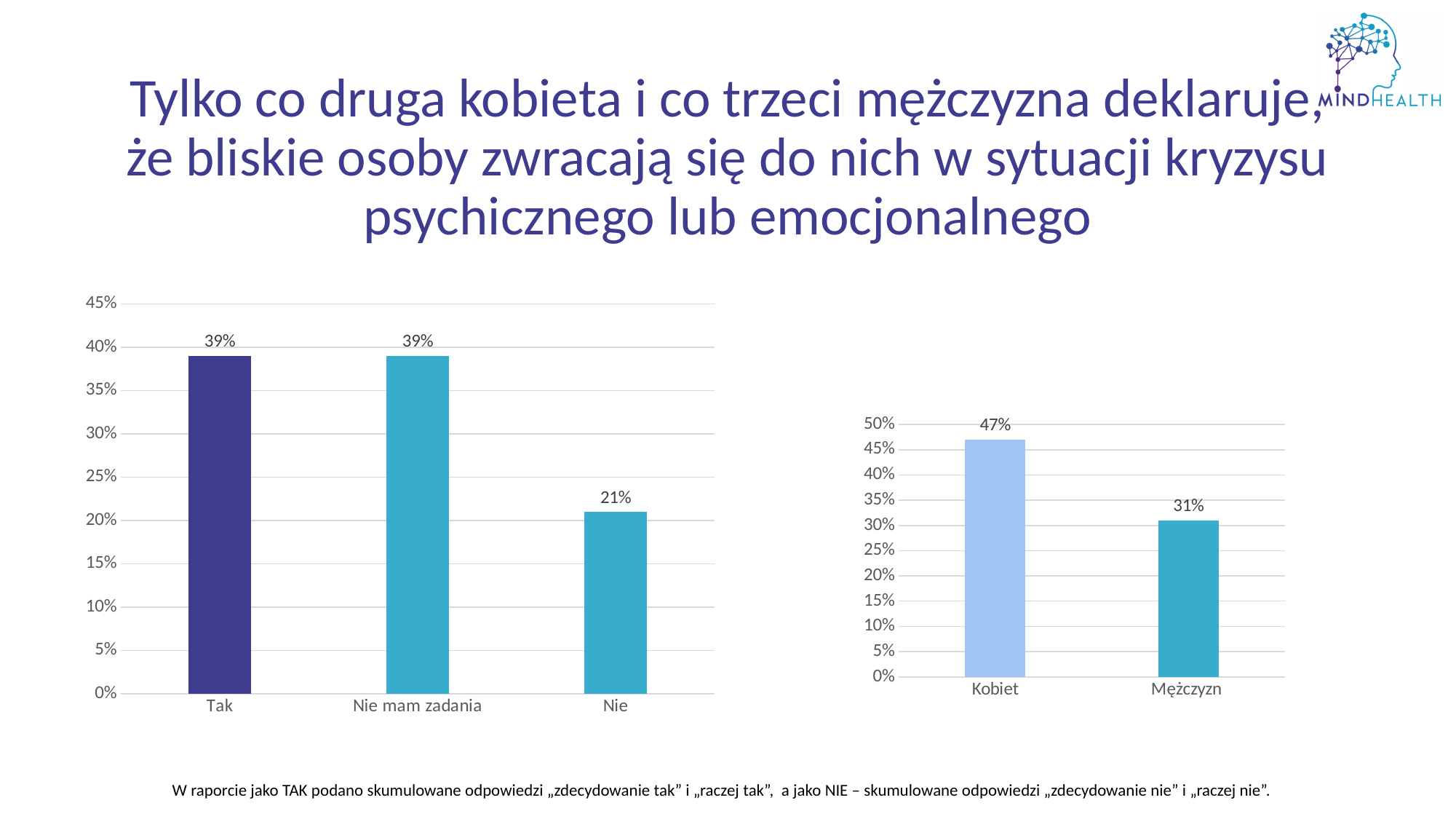
In the left chart, what is the value for "Tak"? 39% In the left chart, what is the value for "Nie"? 21% What kind of chart is the right chart? Bar chart In the right chart, is the value for "Mężczyzn" greater or less than 35%? less In the left chart, how many categories are shown? 3 In the left chart, what is the value for "Nie mam zdania"? 39% In the left chart, which category has the lowest value? Nie In the right chart, what is the difference between the values for "Kobiet" and "Mężczyzn"? 16% In the left chart, what is the difference between the values for "Tak" and "Nie"? 18% In the right chart, what is the value for "Kobiet"? 47% In the right chart, which category has the higher value, "Kobiet" or "Mężczyzn"? Kobiet In the right chart, what is the value for "Mężczyzn"? 31%